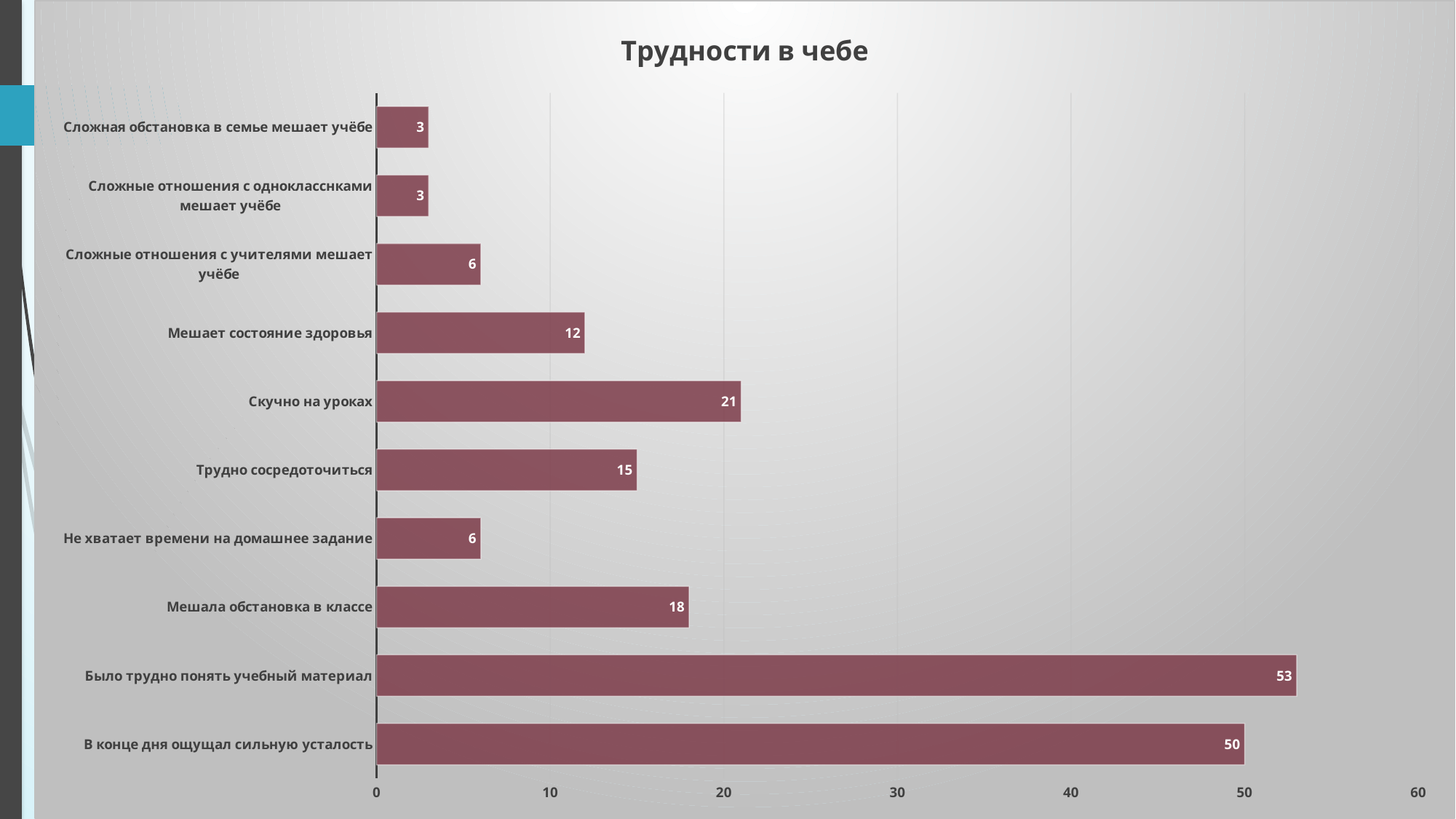
How many categories are shown in the chart? 10 What is the value for "Мешает состояние здоровья"? 12 What is the value for "Сложные отношения с учителями мешает учёбе"? 6 What is the value for "Было трудно понять учебный материал"? 53 What is the difference between "Было трудно понять учебный материал" and "В конце дня ощущал сильную усталость"? 3 What kind of chart is shown on the slide? bar chart What is the value for "Скучно на уроках"? 21 What is the difference between "Мешала обстановка в классе" and "Не хватает времени на домашнее задание"? 12 Is the value for "Мешала обстановка в классе" greater or less than 20? less Which category has the highest value? Было трудно понять учебный материал Which is larger: "Скучно на уроках" or "Трудно сосредоточиться"? Скучно на уроках What is the title of the chart? Трудности в чебе